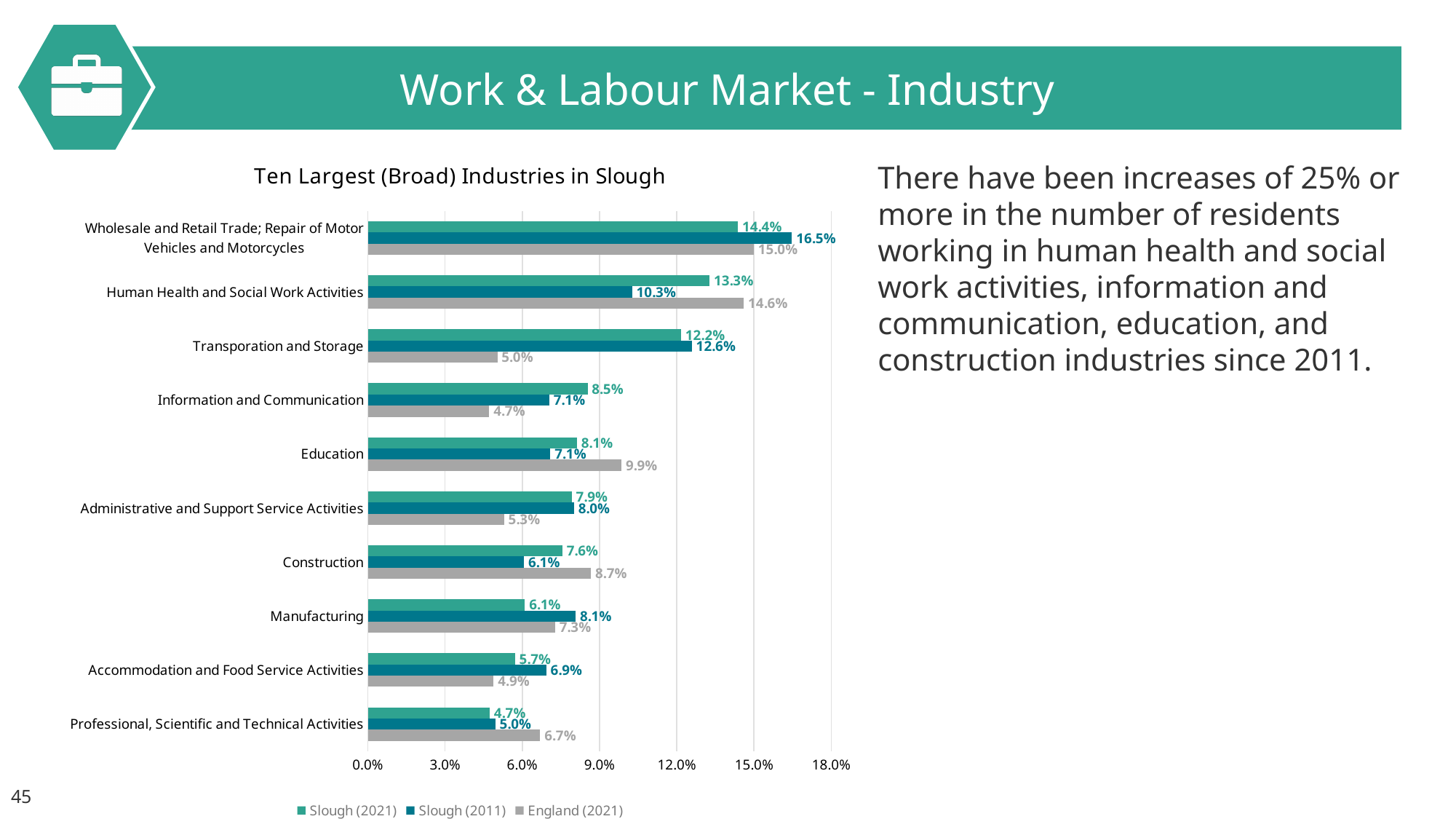
What is the difference between the Slough (2021) and Slough (2011) values for Human Health and Social Work Activities? 3.0% What is the England (2021) value for Transporation and Storage? 5.0% Which industry has the lowest England (2021) value? Information and Communication Which industry has the highest Slough (2021) value? Wholesale and Retail Trade; Repair of Motor Vehicles and Motorcycles What is the title of the chart? Ten Largest (Broad) Industries in Slough Which is larger for Education: the Slough (2021) value or the England (2021) value? England (2021) How many industries are shown on the chart? 10 How many series does the legend list? 3 What kind of chart is shown on the slide? Bar chart What is the Slough (2021) value for Human Health and Social Work Activities? 13.3% What is the difference between the Slough (2011) and England (2021) values for Transporation and Storage? 7.6% What is the Slough (2011) value for Manufacturing? 8.1%